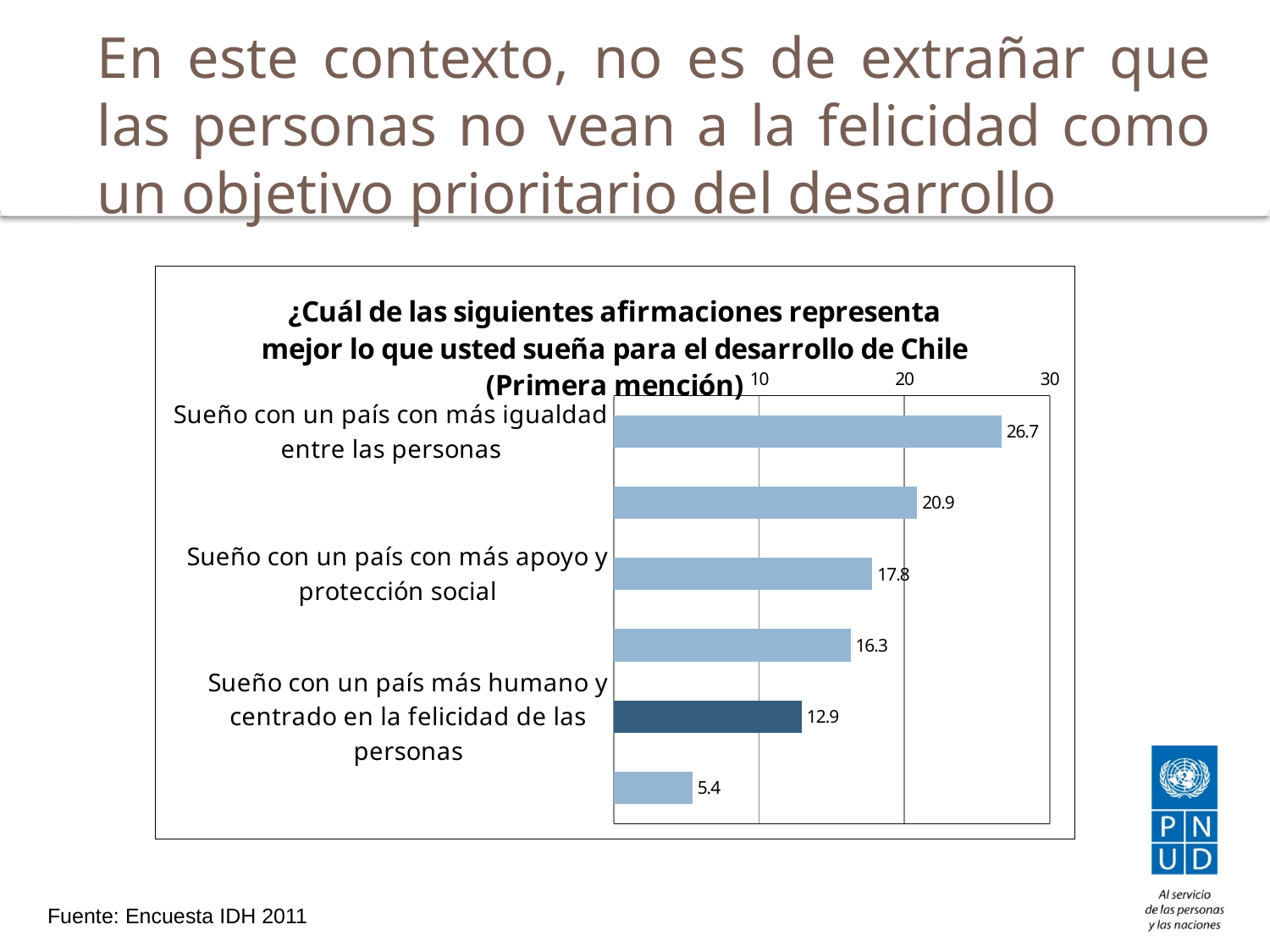
What is the difference between the values for "Sueño con un país con más apoyo y protección social" and "Sueño con un país más humano y centrado en la felicidad de las personas"? 4.9 What is the lowest value shown in the chart? 5.4 What is the difference between the values for "Sueño con un país con más igualdad entre las personas" and "Sueño con un país más humano y centrado en la felicidad de las personas"? 13.8 What is the value for "Sueño con un país más humano y centrado en la felicidad de las personas"? 12.9 What is the value for "Sueño con un país con más apoyo y protección social"? 17.8 Which category has the highest value? Sueño con un país con más igualdad entre las personas How many bars are plotted in the chart? 6 What type of chart is shown on the slide? bar chart Which is larger: the value for "Sueño con un país con más apoyo y protección social" or for "Sueño con un país más humano y centrado en la felicidad de las personas"? Sueño con un país con más apoyo y protección social Is the value for "Sueño con un país con más igualdad entre las personas" greater or less than 20? greater What is the value for "Sueño con un país con más igualdad entre las personas"? 26.7 Which category's bar is drawn in a darker blue than the others? Sueño con un país más humano y centrado en la felicidad de las personas